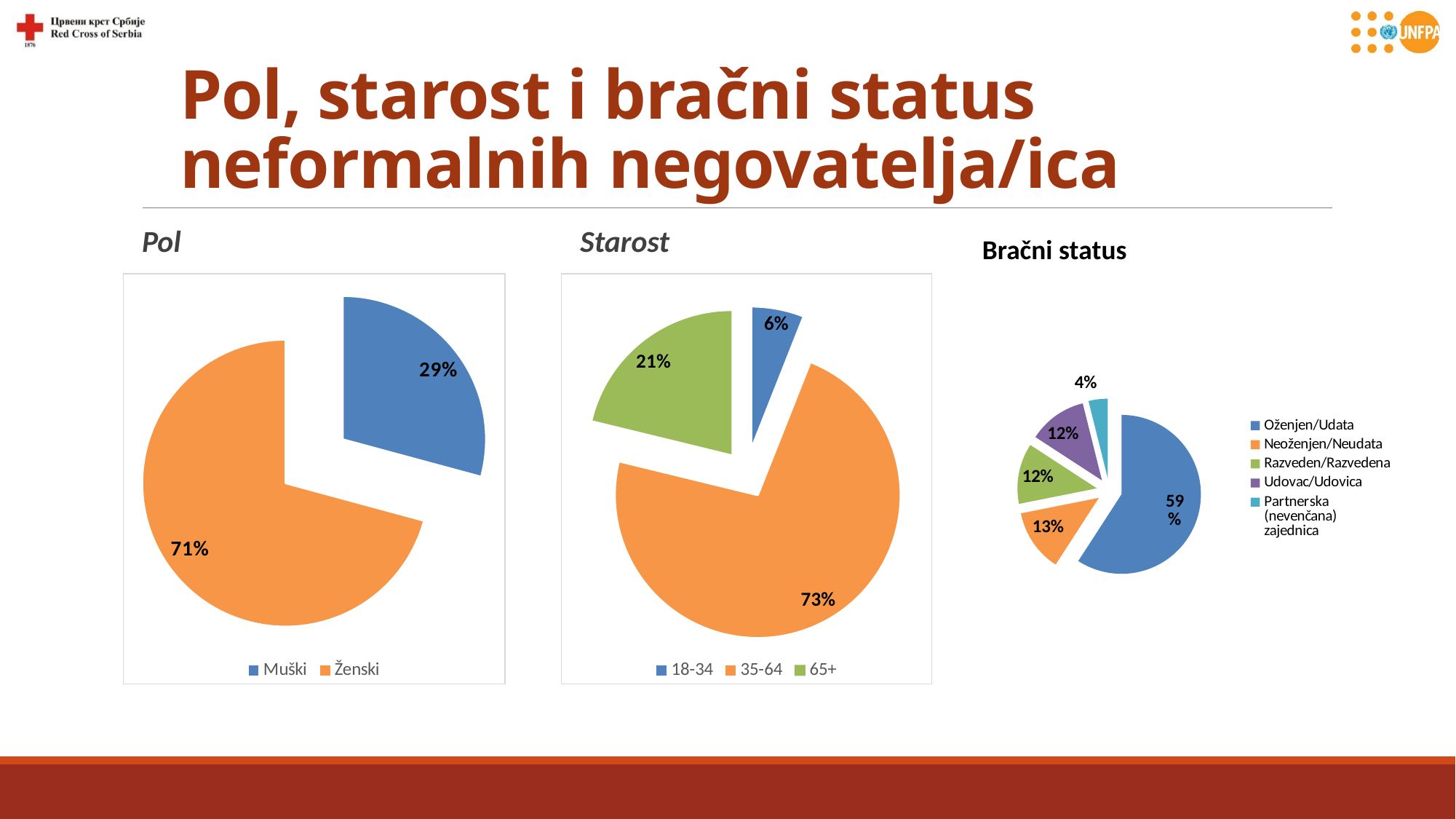
In the 'Bračni status' chart, which is larger: the share for Neoženjen/Neudata or the share for Partnerska (nevenčana) zajednica? Neoženjen/Neudata In the 'Bračni status' chart, how many categories does the legend list? 5 In the 'Pol' chart, what share is labelled for Ženski? 71% In the 'Starost' chart, which age group has the smallest share? 18-34 In the 'Starost' chart, what is the difference between the shares for 65+ and 18-34? 15% In the 'Pol' chart, what kind of chart is shown? Pie chart In the 'Bračni status' chart, what share is labelled for Oženjen/Udata? 59% In the 'Starost' chart, what share is labelled for the 35-64 group? 73% In the 'Bračni status' chart, which category has the smallest share? Partnerska (nevenčana) zajednica In the 'Bračni status' chart, what colour is the Udovac/Udovica slice? Purple In the 'Starost' chart, how many age groups does the legend list? 3 In the 'Pol' chart, what share is labelled for Muški? 29%